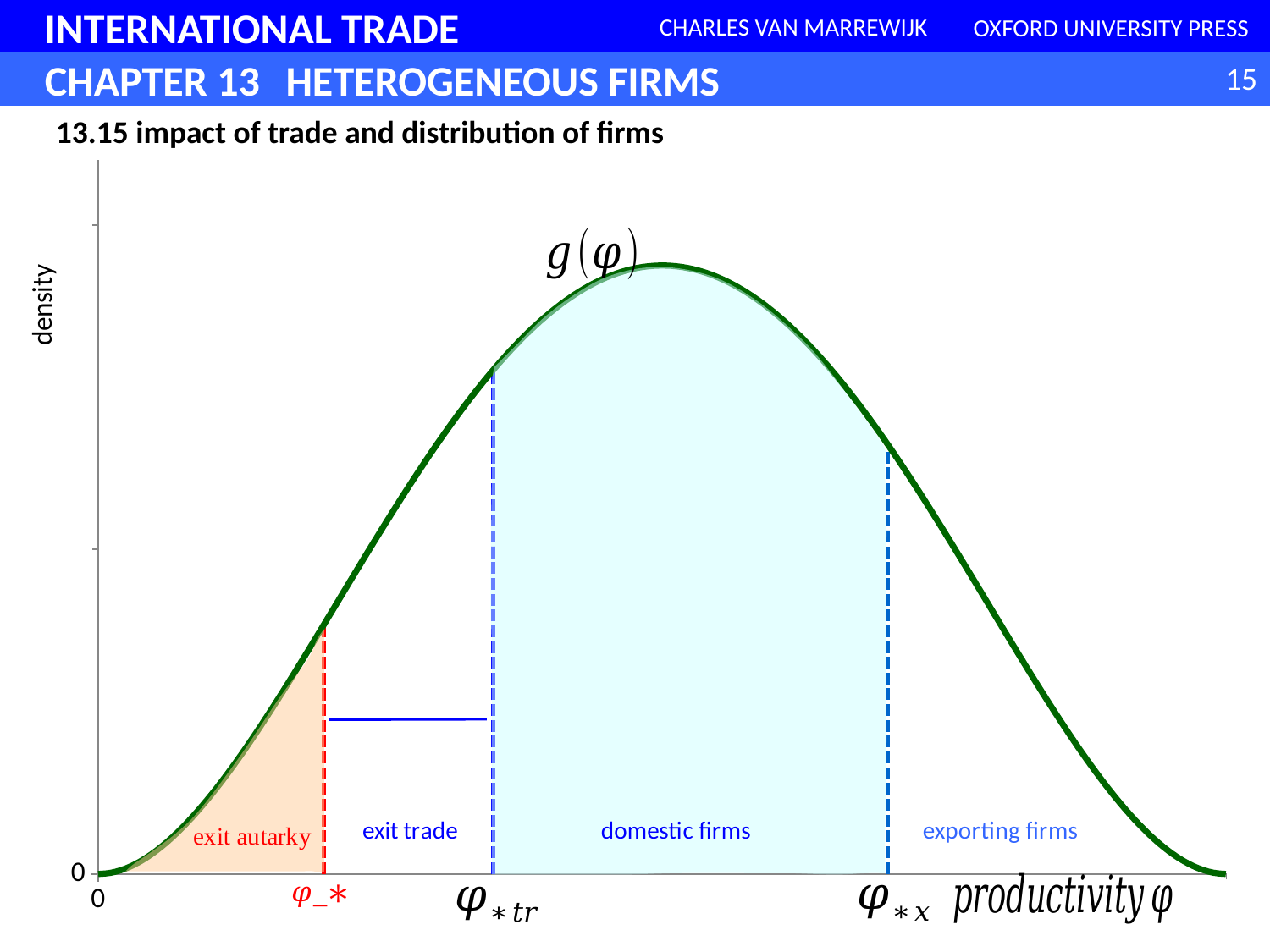
What kind of chart is shown on the slide? line chart In which labeled region does the curve g(φ) reach its peak? domestic firms How many labeled firm regions are marked along the productivity axis? 4 Is the density at φ_*tr higher or lower than the density at φ_*x? higher Which region lies to the left of φ_*? exit autarky What is the title of the chart? 13.15 impact of trade and distribution of firms Is the density at φ_*tr higher or lower than the density at φ_*? higher Between 0 and φ_*, does the density curve rise or fall as productivity increases? rise To the right of φ_*x, does the density curve rise or fall as productivity increases? fall Which region lies to the right of φ_*x? exporting firms Which region lies between φ_* and φ_*tr? exit trade What is the label on the vertical axis? density